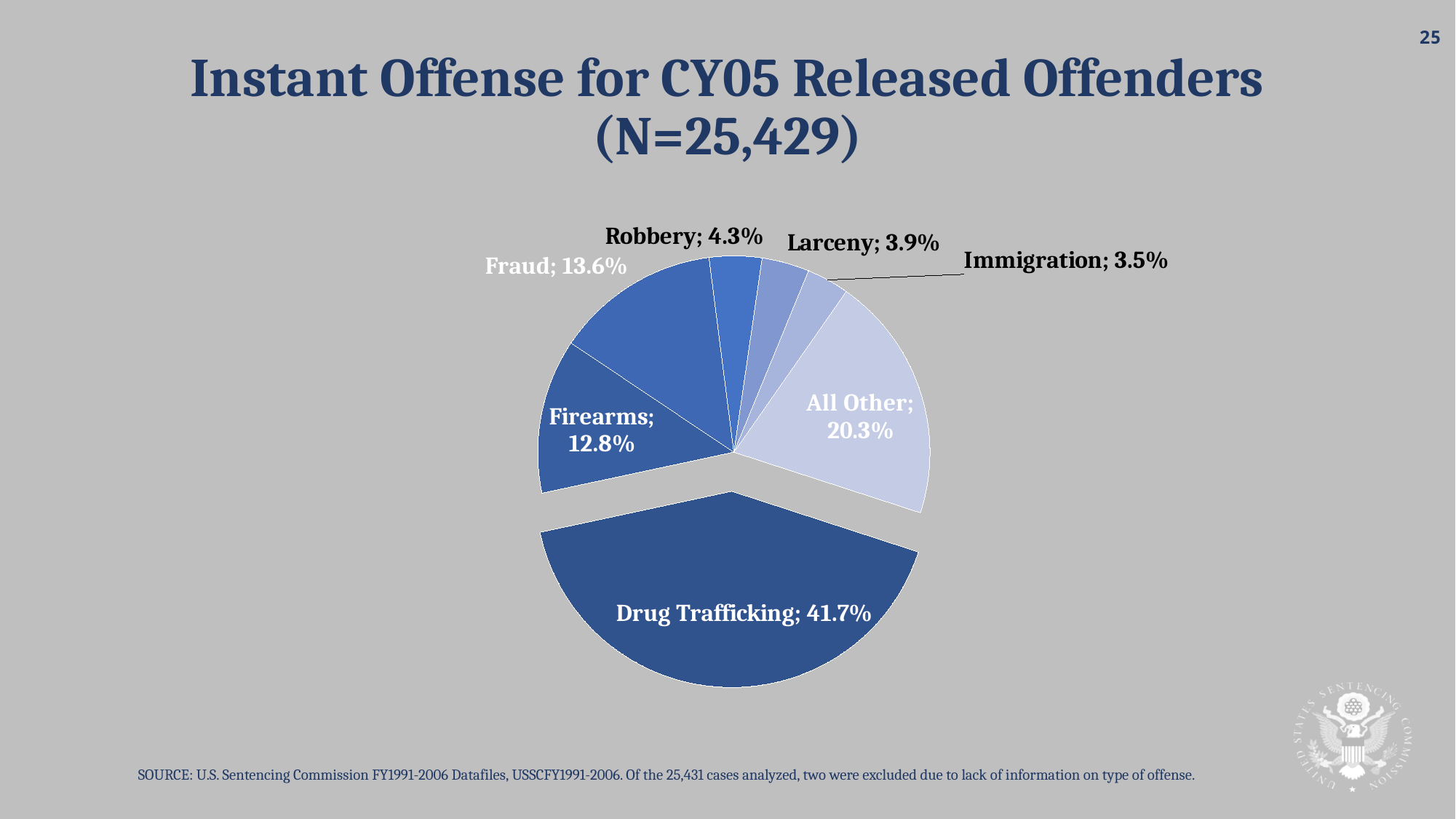
How many offense categories are shown in the pie chart? 7 What percentage is shown for Immigration? 3.5% What is the N value given in the chart title? 25,429 What is the difference in percentage points between Fraud and Firearms? 0.8 What is the combined percentage of Drug Trafficking and All Other? 62.0% Which offense category has the largest share of the pie? Drug Trafficking Which is larger, the share for Robbery or the share for Larceny? Robbery What percentage is shown for All Other? 20.3% What share of CY05 released offenders had Drug Trafficking as their instant offense? 41.7% Which offense category has the smallest share of the pie? Immigration What kind of chart is shown on the slide? Pie chart What percentage is shown for Firearms? 12.8%